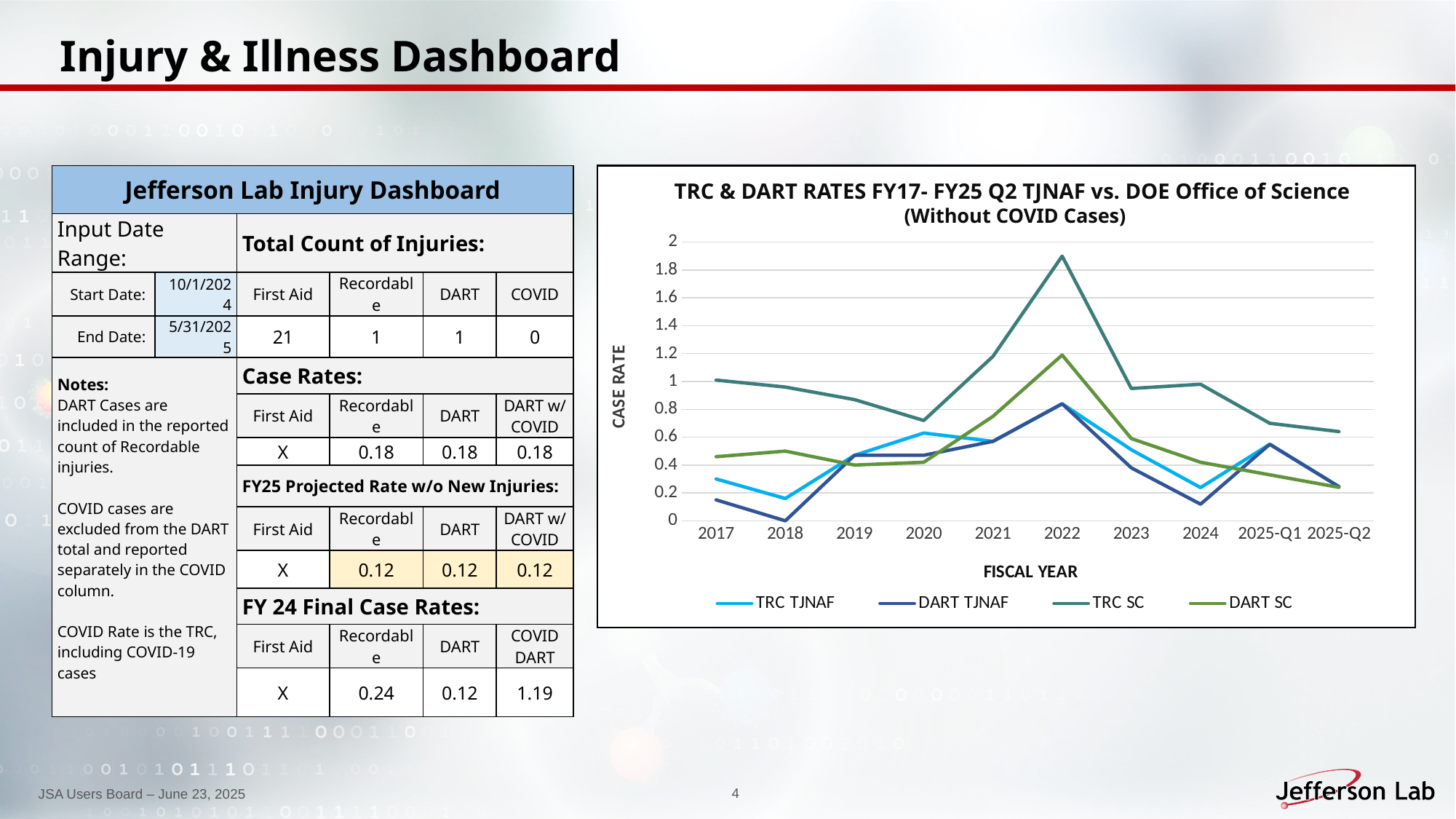
In which fiscal year does the TRC SC series reach its highest value? 2022 In which fiscal year does the DART TJNAF series reach its lowest value? 2018 Is the DART SC value for 2022 greater or less than 1? greater Is the TRC SC value for 2020 greater or less than 0.8? less Does the TRC SC series generally rise or fall from 2022 to 2025-Q2? fall What kind of chart is shown on the slide? line chart Is the DART TJNAF value for 2018 greater or less than 0.2? less In 2022, which series has the larger value, TRC SC or DART SC? TRC SC How many fiscal-year categories are shown on the x axis of the chart? 10 How many series does the legend of the chart list? 4 In 2017, which series has the larger value, TRC SC or TRC TJNAF? TRC SC